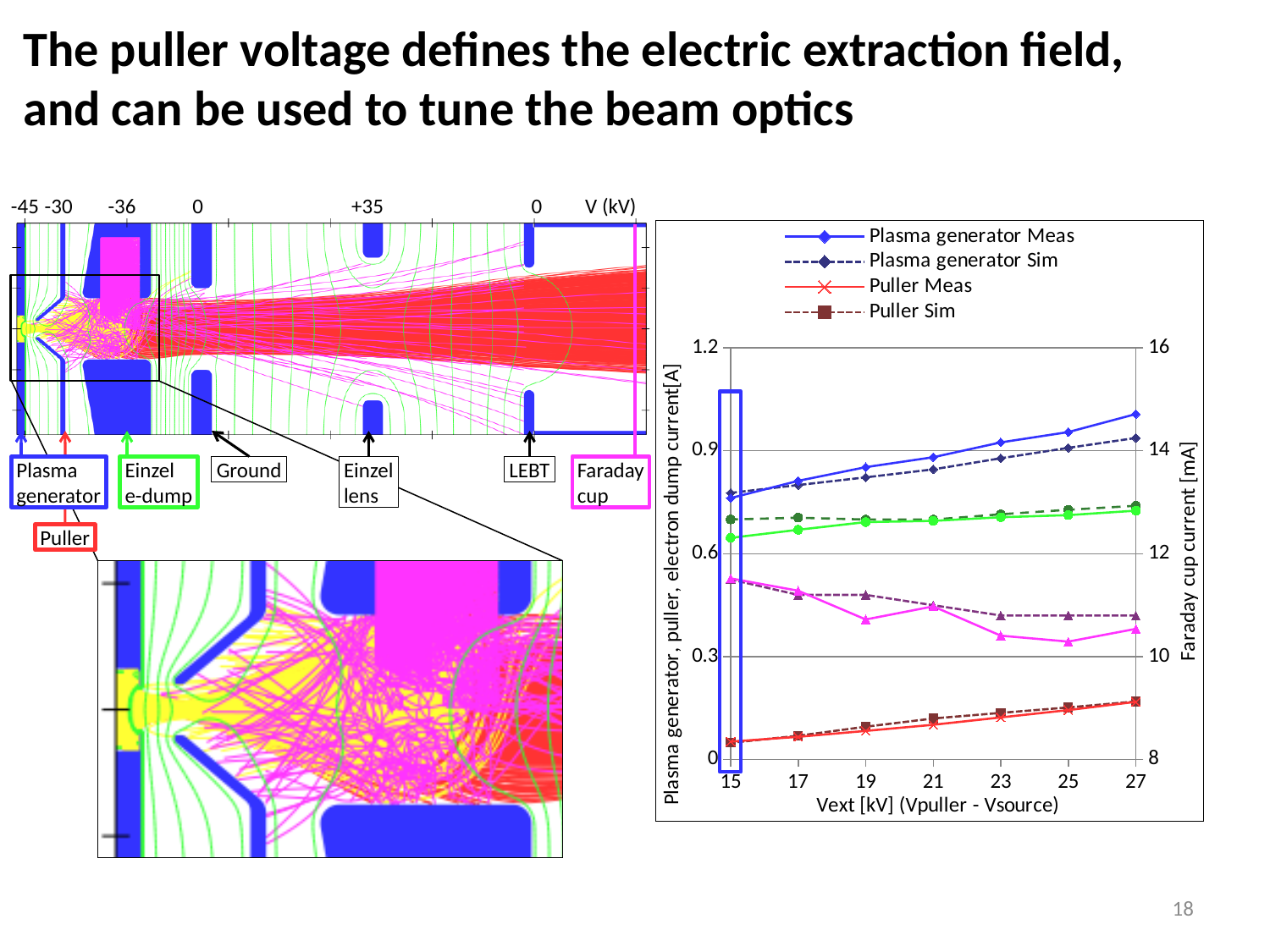
Does the Puller Meas series rise or fall as Vext increases from 15 to 27 kV? rise Is the Puller Meas value at Vext = 27 kV greater or less than 0.3 on the left axis? less How many series does the legend of the chart list? 4 At which Vext value is the Plasma generator Meas current lowest? 15 At Vext = 21 kV, which is larger: Plasma generator Meas or Puller Meas? Plasma generator Meas What kind of chart is shown on the right side of the slide? line chart Is the Plasma generator Meas value at Vext = 27 kV greater or less than 0.9 on the left axis? greater How many Vext values are marked on the x axis of the chart? 7 Is the Plasma generator Sim value at Vext = 15 kV greater or less than 0.6 on the left axis? greater Does the Plasma generator Meas series rise or fall as Vext increases from 15 to 27 kV? rise What is the title of the x axis of the chart? Vext [kV] (Vpuller - Vsource) At which Vext value is the Plasma generator Meas current highest? 27